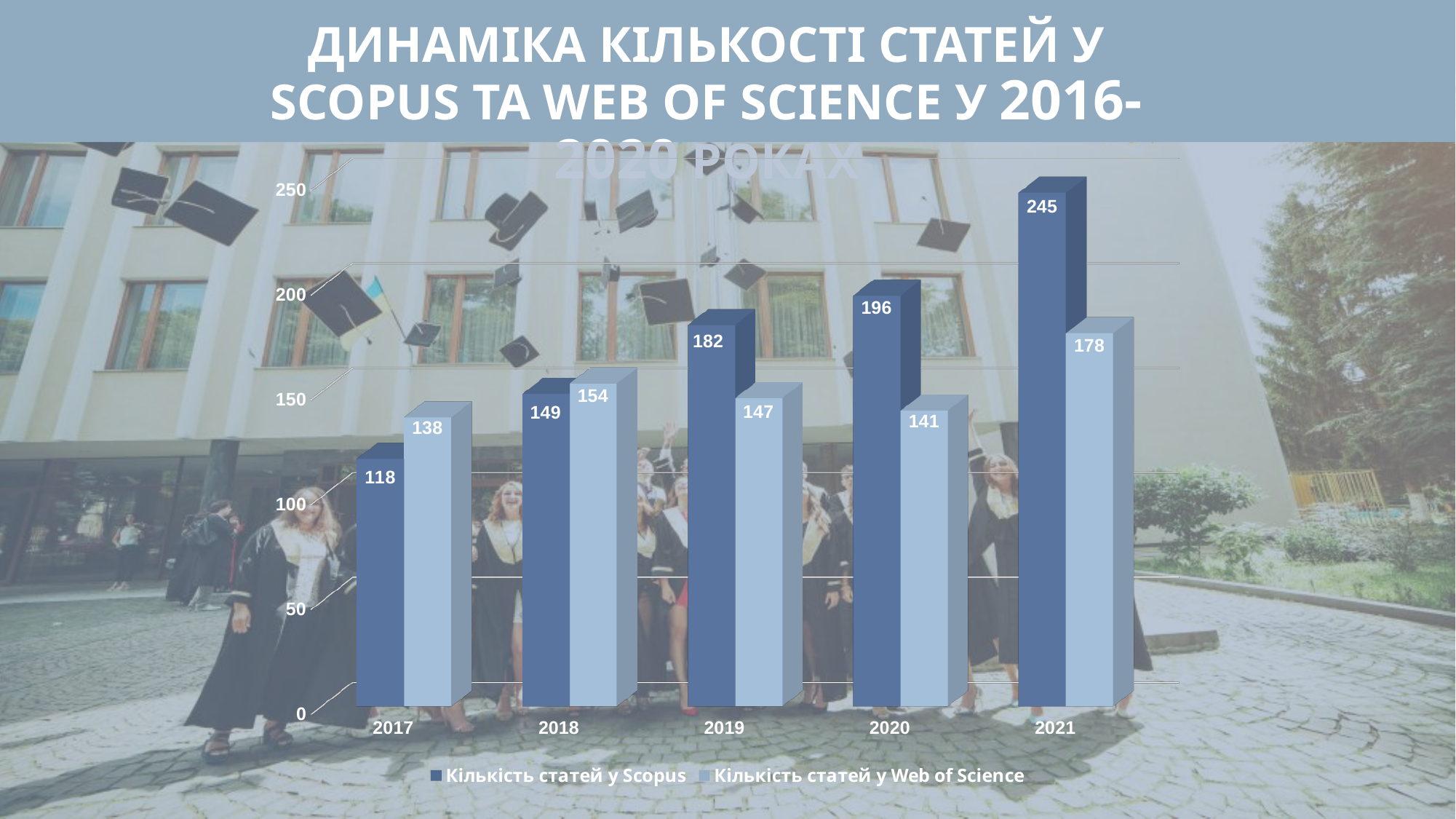
How many years are shown on the x axis? 5 How many series does the legend list? 2 How many articles in Scopus were there in 2019? 182 What kind of chart is shown on the slide? bar chart In which year was the number of Scopus articles highest? 2021 Which was larger in 2017: the number of Scopus articles or the number of Web of Science articles? Web of Science What is the value for Web of Science articles in 2018? 154 What is the difference between Scopus and Web of Science articles in 2021? 67 In which year was the number of Web of Science articles lowest? 2017 Which series is shown in the darker blue colour? Кількість статей у Scopus Do the Scopus article counts rise or fall from 2017 to 2021? rise What is the value for Scopus articles in 2020? 196